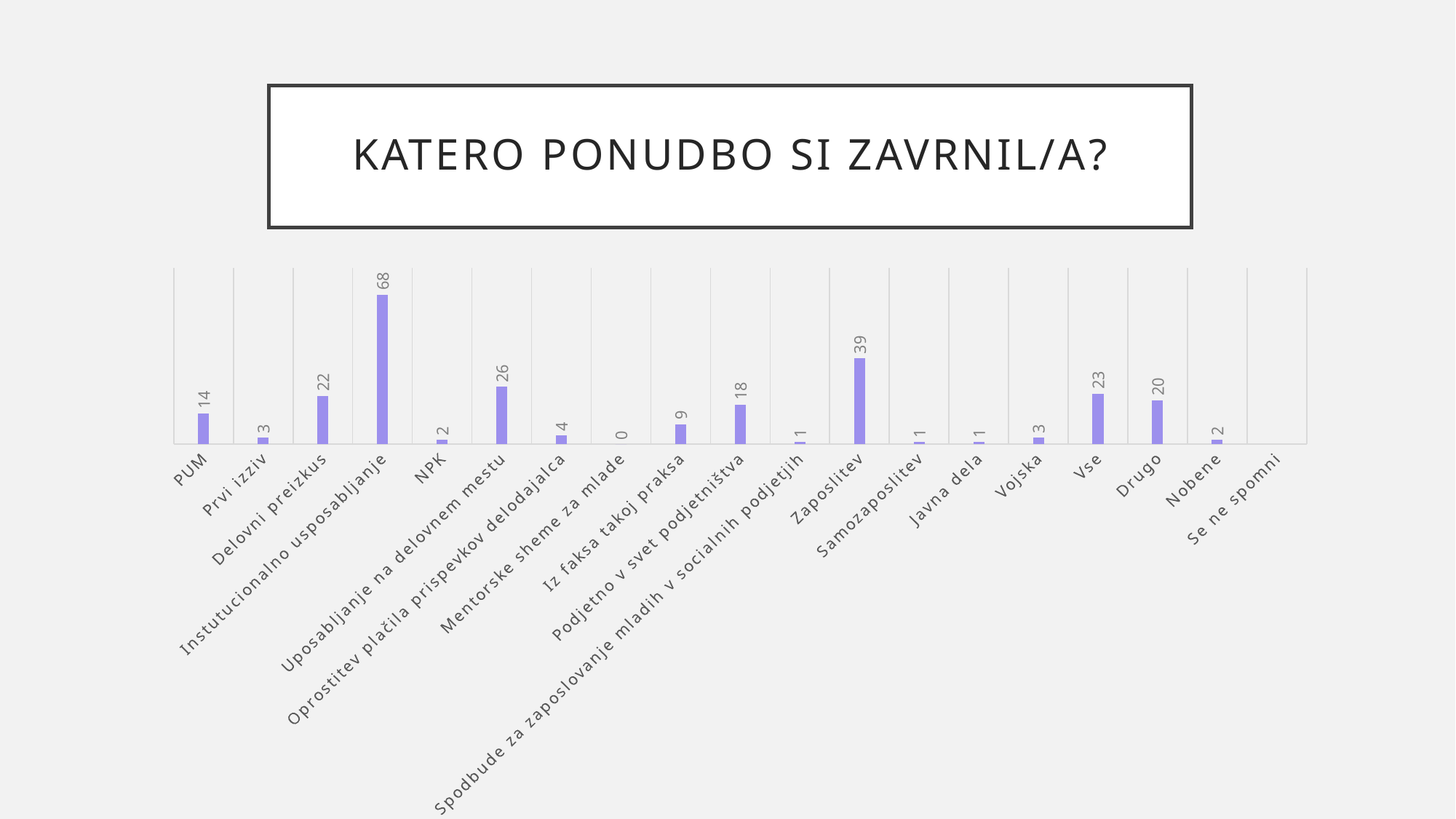
What is the value for Uposabljanje na delovnem mestu? 26 What type of chart is shown on the slide? bar chart What is the title of the slide? KATERO PONUDBO SI ZAVRNIL/A? What is the difference between the values for Vse and Drugo? 3 What is the value for Mentorske sheme za mlade? 0 Which is larger, the value for Iz faksa takoj praksa or the value for Oprostitev plačila prispevkov delodajalca? Iz faksa takoj praksa Which category has the highest value? Instutucionalno usposabljanje Which is larger, the value for PUM or the value for Podjetno v svet podjetništva? Podjetno v svet podjetništva What is the value for Delovni preizkus? 22 What is the difference between the values for Instutucionalno usposabljanje and Zaposlitev? 29 What is the value for Zaposlitev? 39 How many categories are shown on the x axis? 19